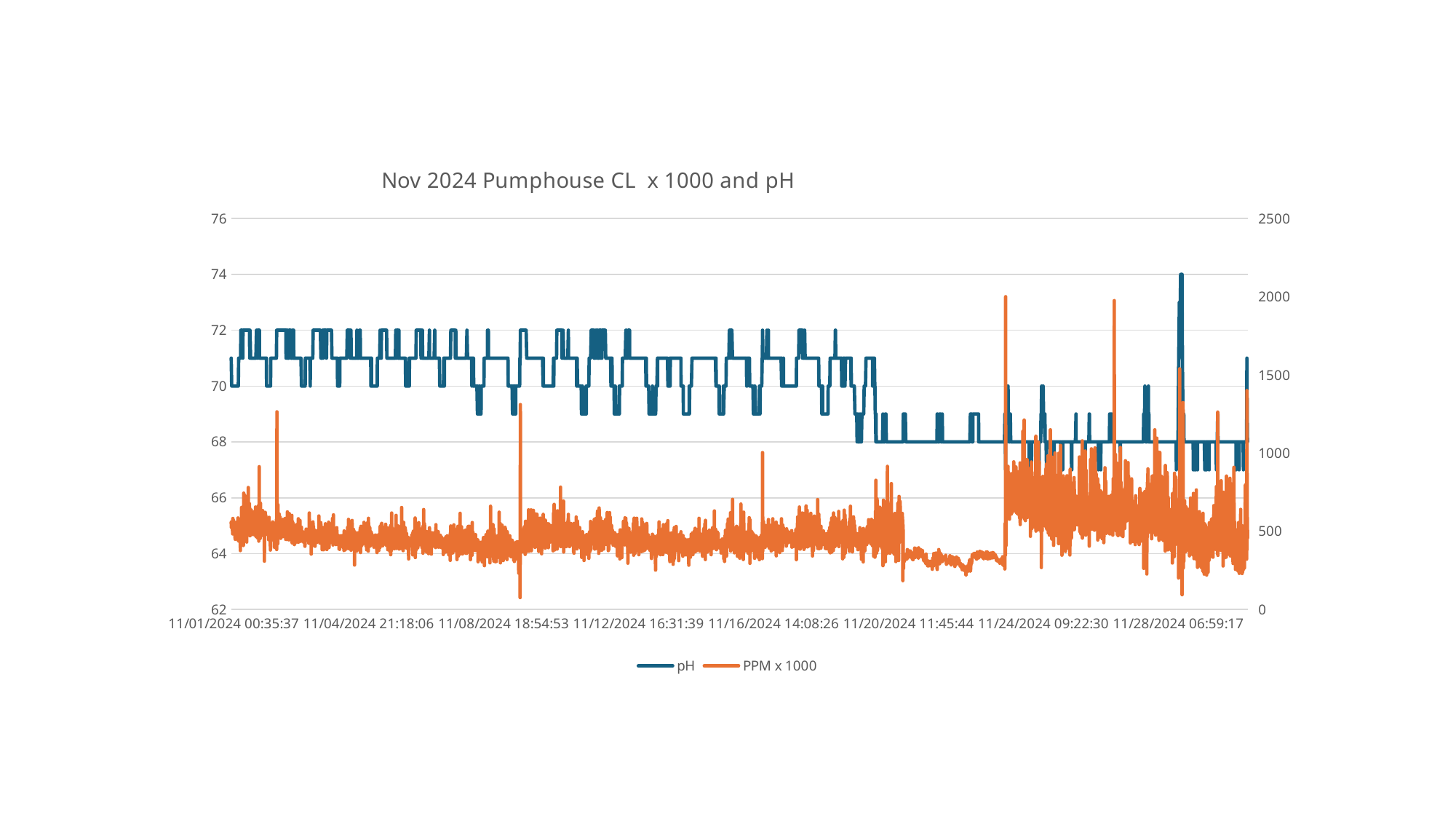
What kind of chart is shown on the slide? line chart What is the title of the chart? Nov 2024 Pumphouse CL x 1000 and pH Around 11/24/2024, does the PPM x 1000 series jump up or drop down? up Is the highest pH value on the chart greater or less than 72? greater Between 11/20/2024 and 11/24/2024, is the PPM x 1000 series mostly greater or less than 500? less How many series does the legend list? 2 Is the lowest pH value on the chart greater or less than 68? less Which series is drawn in orange? PPM x 1000 Does the pH series generally rise or fall from the start of November to the end of November? fall